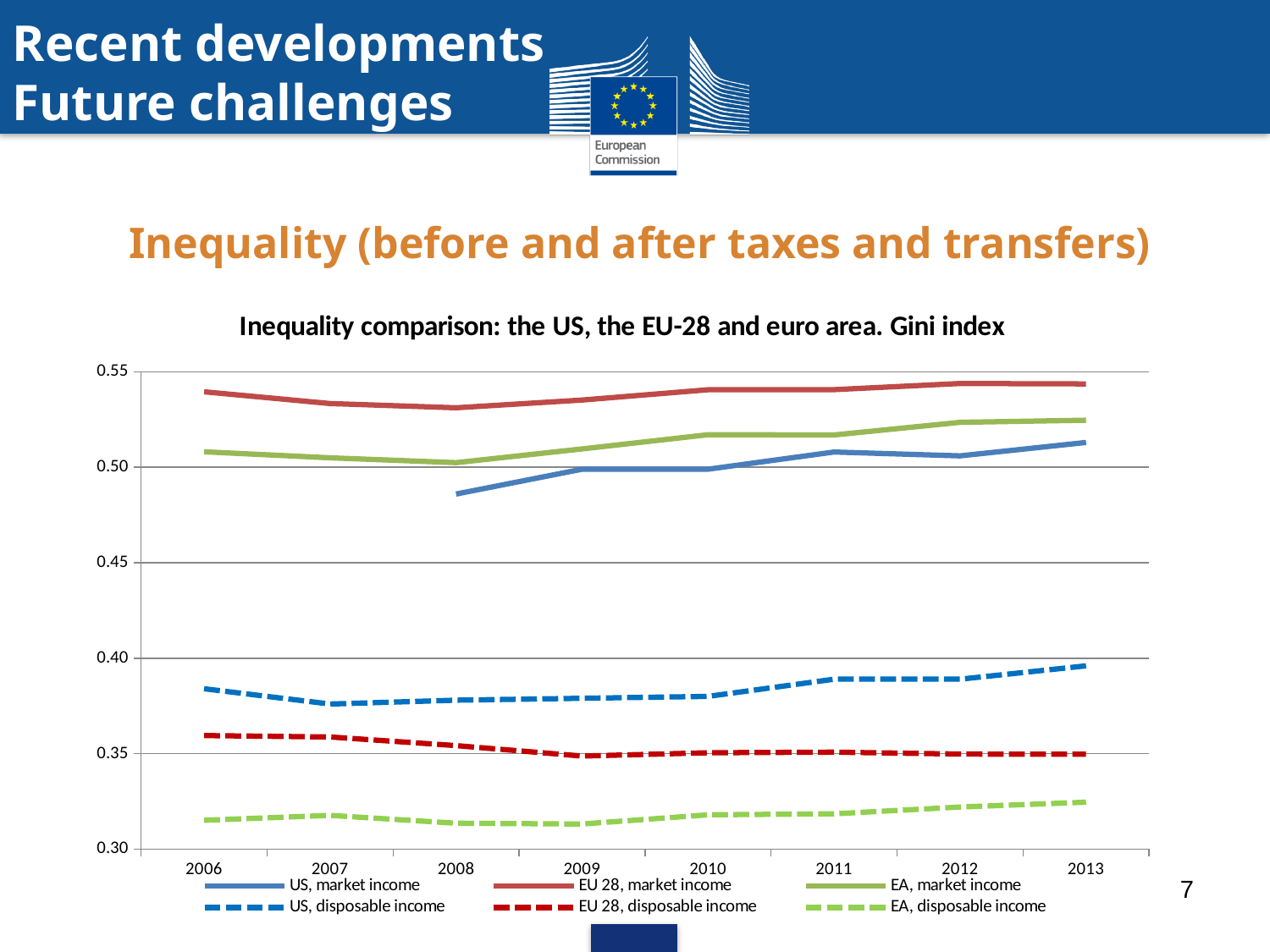
Is the value for US, market income in 2008 greater or less than 0.50? less What kind of chart is shown on the slide? line chart Which series has the highest value in 2013? EU 28, market income Is the value for US, disposable income in 2007 greater or less than 0.40? less How many series does the legend list? 6 In 2013, which is larger: EU 28, market income or EA, market income? EU 28, market income Is the value for EU 28, market income in 2006 greater or less than 0.50? greater How many years are shown on the x axis? 8 What is the title of the chart? Inequality comparison: the US, the EU-28 and euro area. Gini index Does US, market income rise or fall from 2008 to 2013? rise Which series has the lowest value in 2006? EA, disposable income Does EU 28, disposable income rise or fall from 2006 to 2009? fall